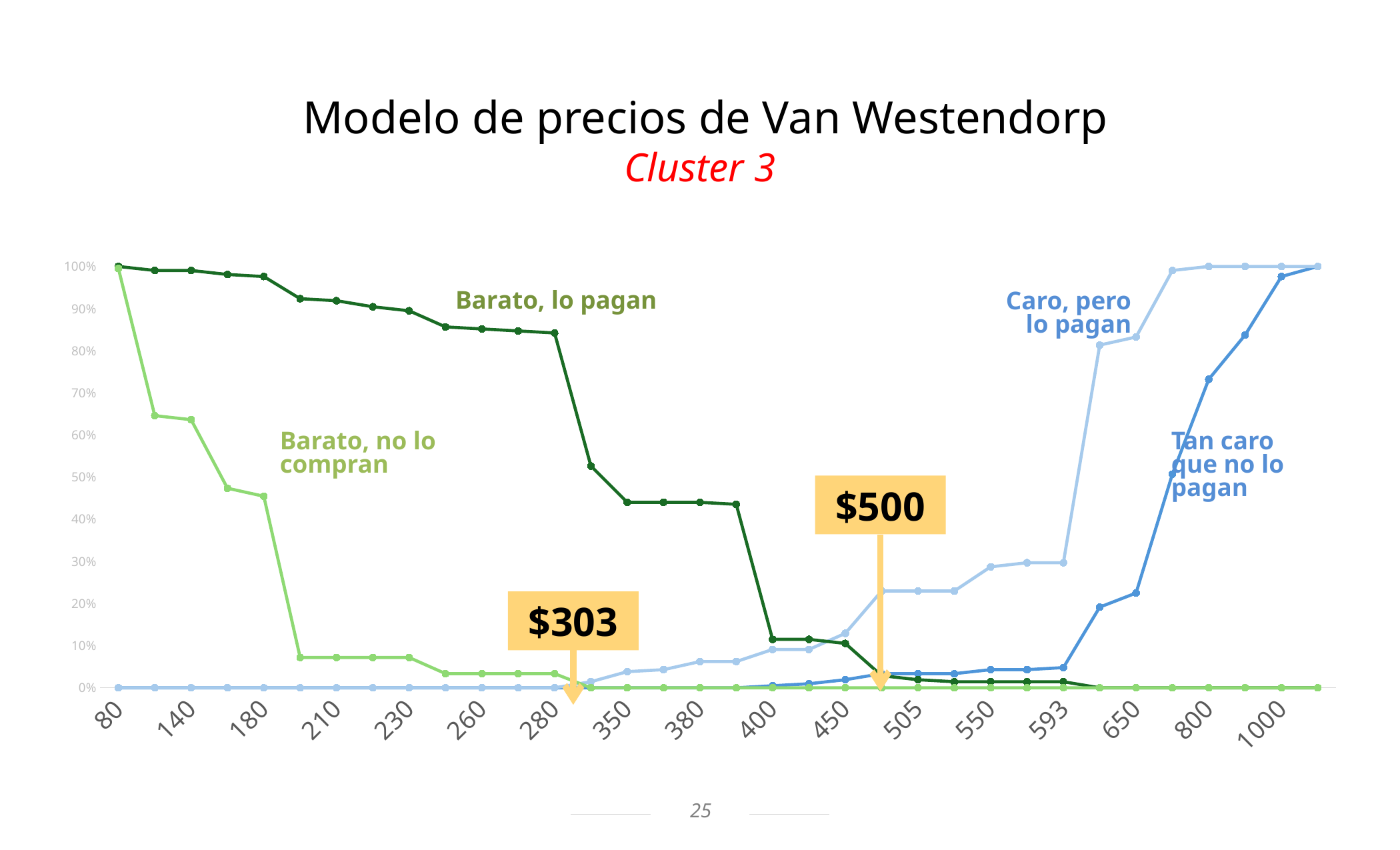
Does the 'Tan caro que no lo pagan' series rise or fall as price increases along the x axis? rise Is the value of 'Barato, lo pagan' at a price of 280 greater or less than 80%? greater Is the value of 'Tan caro que no lo pagan' at a price of 800 greater or less than 70%? greater How many price labels are shown along the x axis? 17 What two price values are highlighted with yellow callout boxes on the chart? $303 and $500 What is the value of the 'Tan caro que no lo pagan' series at a price of 80? 0% What is the value of the 'Barato, lo pagan' series at a price of 80? 100% What kind of chart is shown on the slide? line chart How many series are plotted on the chart? 4 Is the value of 'Barato, lo pagan' at a price of 350 greater or less than 50%? less What is the value of the 'Caro, pero lo pagan' series at a price of 1000? 100% Does the 'Barato, lo pagan' series rise or fall as price increases along the x axis? fall